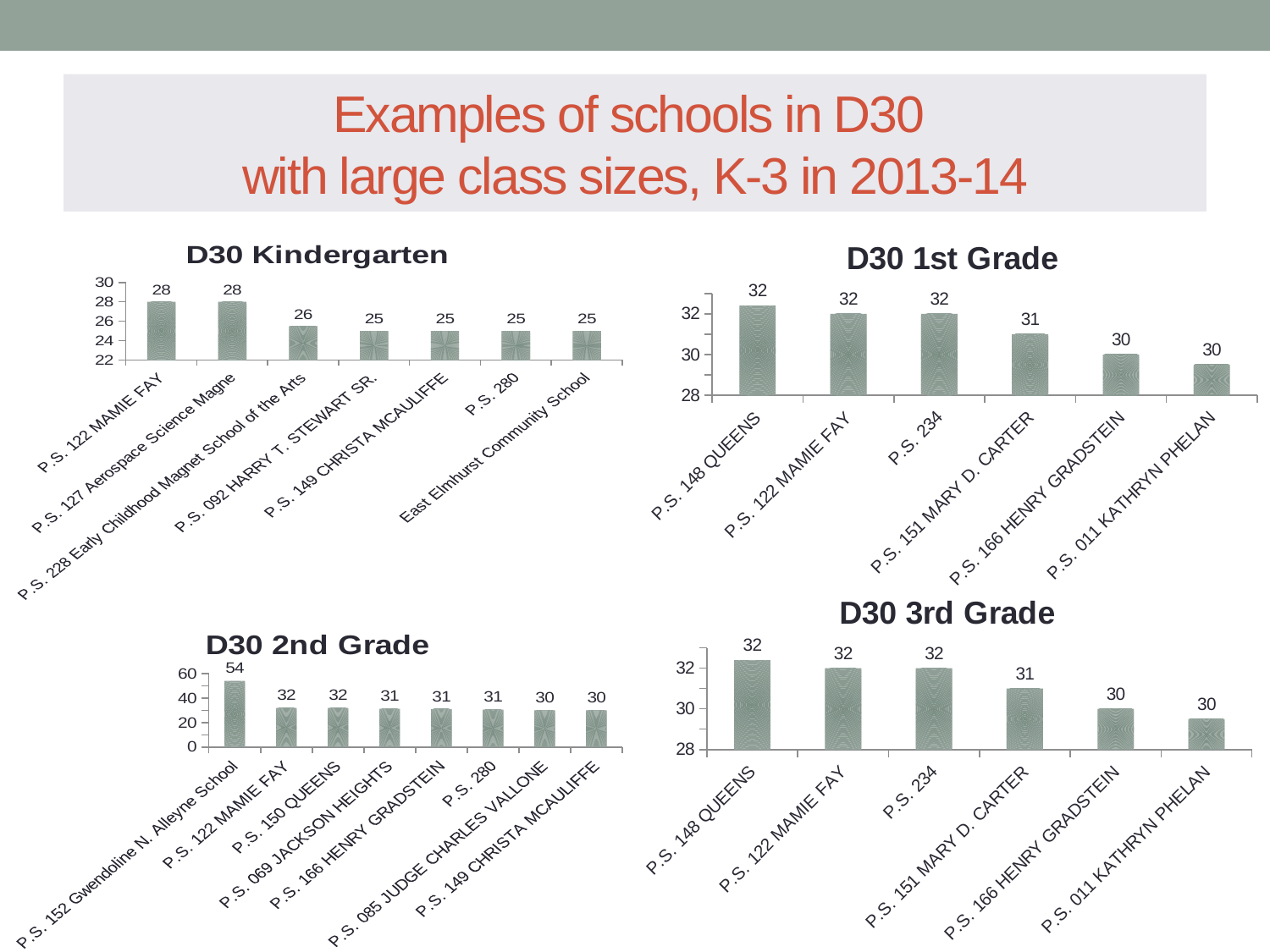
In the D30 1st Grade chart, how many schools are shown? 6 In the D30 Kindergarten chart, what is the difference between P.S. 122 MAMIE FAY and P.S. 280? 3 In the D30 2nd Grade chart, which school has the highest value? P.S. 152 Gwendoline N. Alleyne School In the D30 3rd Grade chart, what is the value for P.S. 011 KATHRYN PHELAN? 30 In the D30 2nd Grade chart, how many schools are shown? 8 What kind of chart is the D30 3rd Grade chart? Bar chart In the D30 1st Grade chart, which is larger, the value for P.S. 234 or the value for P.S. 166 HENRY GRADSTEIN? P.S. 234 In the D30 Kindergarten chart, how many schools are shown? 7 In the D30 2nd Grade chart, what is the difference between P.S. 152 Gwendoline N. Alleyne School and P.S. 122 MAMIE FAY? 22 In the D30 2nd Grade chart, what is the value for P.S. 069 JACKSON HEIGHTS? 31 In the D30 1st Grade chart, what is the value for P.S. 151 MARY D. CARTER? 31 In the D30 Kindergarten chart, what is the value for P.S. 228 Early Childhood Magnet School of the Arts? 26